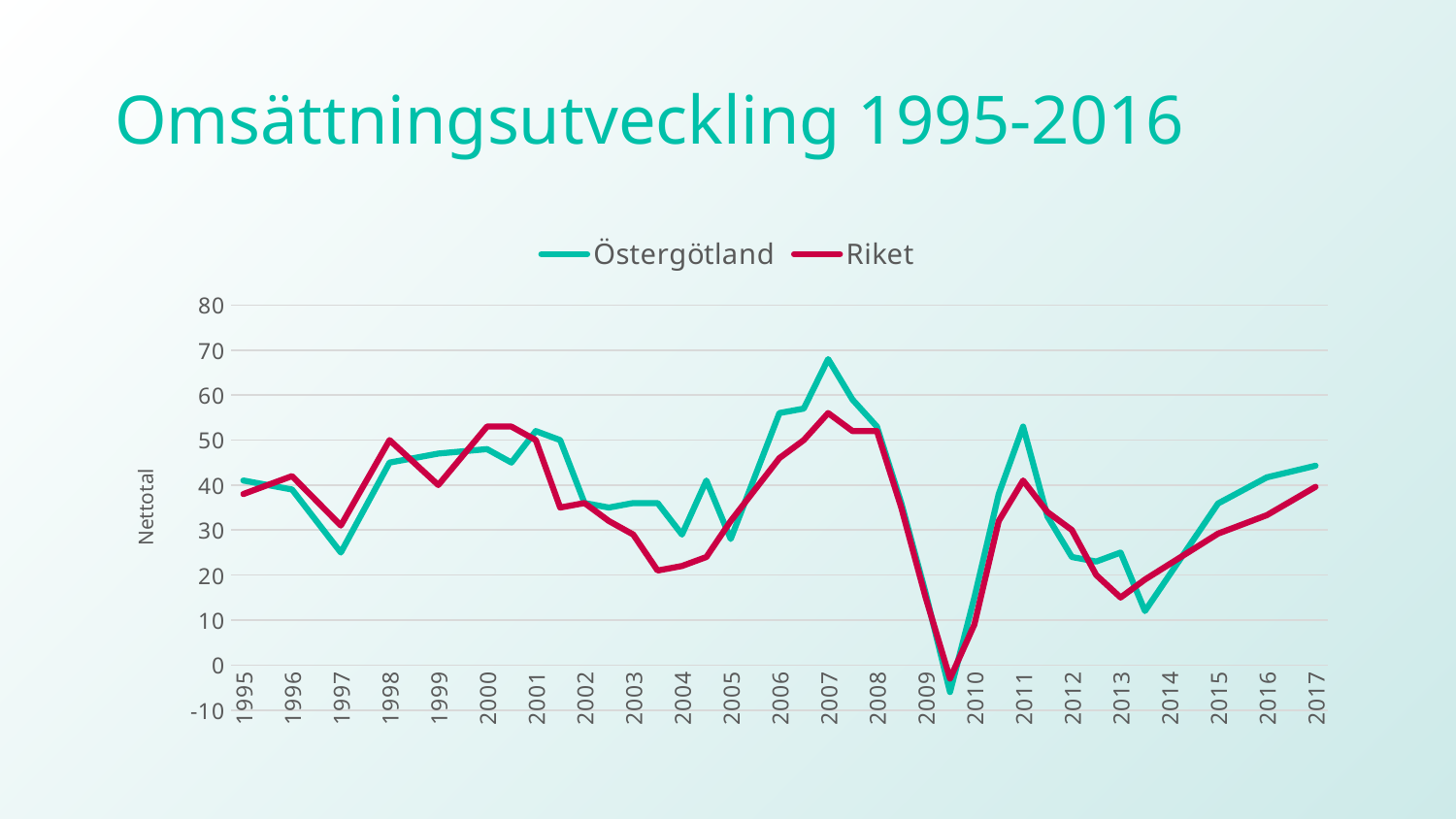
What is the label on the vertical axis? Nettotal Do the values for both series rise or fall between 2007 and 2009? fall In 2004, which series has the higher value, Östergötland or Riket? Östergötland In which year does the Riket line reach its lowest point? 2009 Is the peak value of Östergötland in 2007 greater or less than 60? greater In which year does the Östergötland line reach its highest point? 2007 Is the value for Riket in 2004 greater or less than 30? less Is the lowest value of Östergötland in 2009 greater or less than 0? less How many series does the legend list? 2 What is the title of the chart? Omsättningsutveckling 1995-2016 In 2007, which series has the higher value, Östergötland or Riket? Östergötland What kind of chart is shown on the slide? line chart